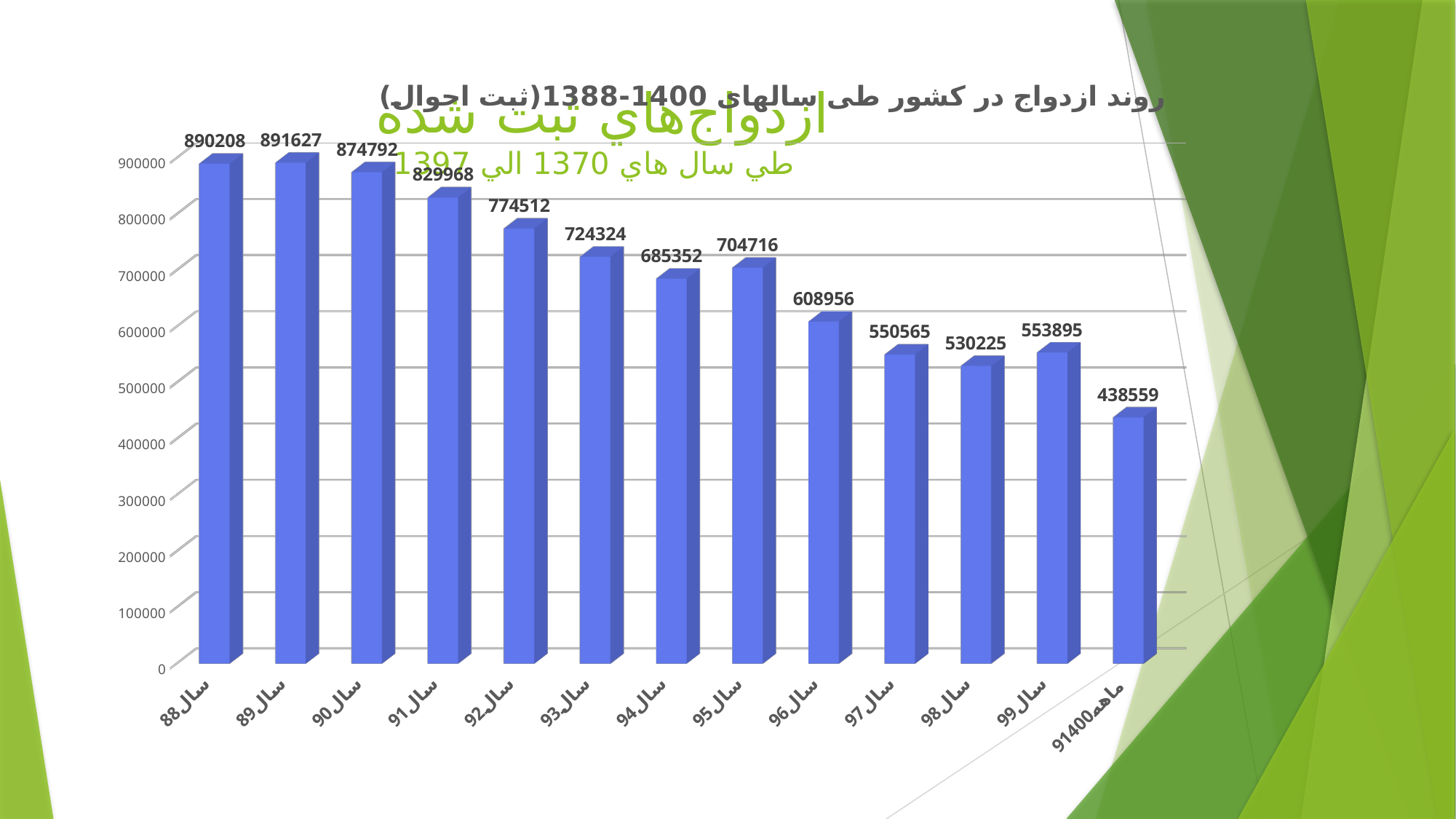
Do the values generally rise or fall from سال 88 to 9ماهه 1400? fall What kind of chart is shown on the slide? bar chart Is the value for سال 92 greater or less than 700000? greater What is the difference between the values for سال 96 and سال 97? 58391 Which is larger, the value for سال 94 or سال 95? سال 95 How many categories are shown on the x axis? 13 What is the value for سال 95? 704716 What is the difference between the values for سال 89 and سال 88? 1419 Which category has the lowest value? 9ماهه 1400 What is the value for 9ماهه 1400? 438559 What is the value for سال 88? 890208 Which category has the highest value? سال 89